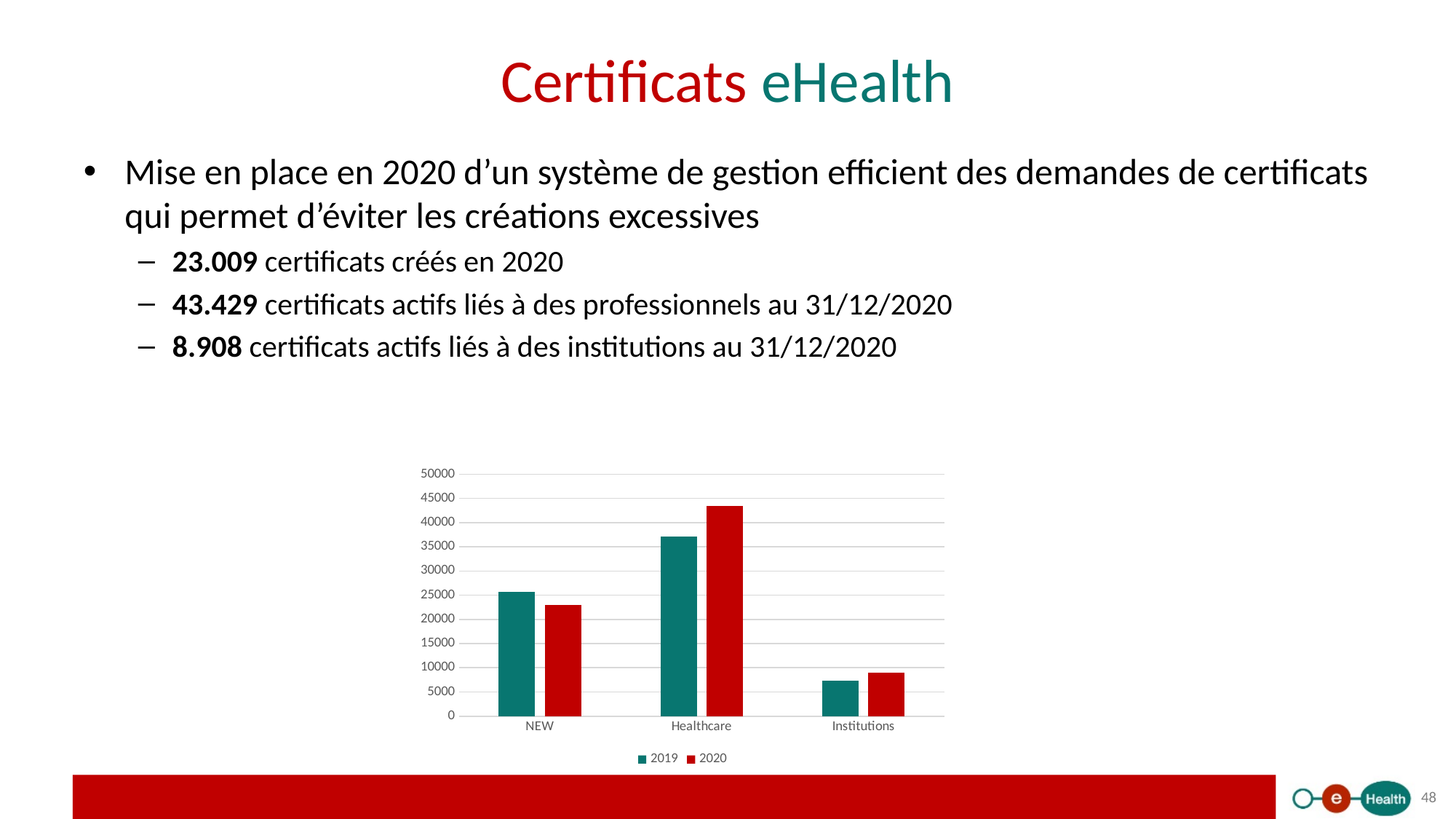
How many categories are shown on the x axis of the chart? 3 Which category has the highest 2020 value in the chart? Healthcare Is the 2020 value for Healthcare greater or less than 40000? greater For the NEW category, which series has the larger value, 2019 or 2020? 2019 Is the 2019 value for NEW greater or less than 30000? less Is the 2019 value for Institutions greater or less than 10000? less For the Healthcare category, which series has the larger value, 2019 or 2020? 2020 How many series does the chart legend list? 2 Which series is shown in red in the chart? 2020 What kind of chart is shown on the slide? bar chart Which category has the lowest 2019 value in the chart? Institutions What is the maximum value shown on the chart's vertical axis? 50000